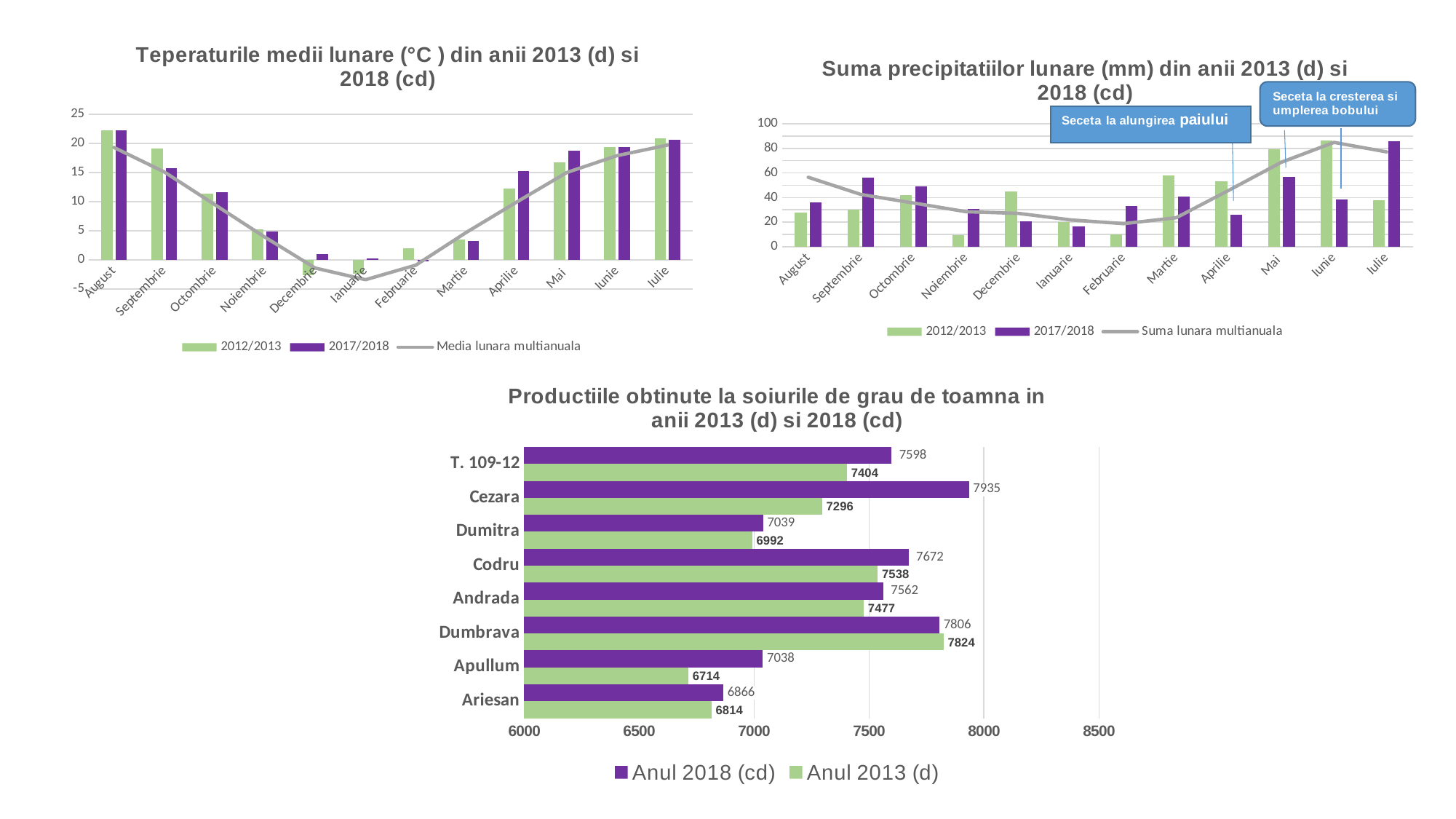
In the top-right chart 'Suma precipitatiilor lunare', which month has the highest 2017/2018 value? Iulie In the chart 'Productiile obtinute la soiurile de grau de toamna', which is larger for Dumbrava: Anul 2018 (cd) or Anul 2013 (d)? Anul 2013 (d) In the top-left chart 'Teperaturile medii lunare', how many entries does the legend list? 3 In the chart 'Productiile obtinute la soiurile de grau de toamna', how many wheat varieties are shown? 8 In the top-left chart 'Teperaturile medii lunare', is the 2012/2013 value for August greater or less than 20? greater In the chart 'Productiile obtinute la soiurile de grau de toamna', what is the value for Dumbrava in Anul 2013 (d)? 7824 In the top-right chart 'Suma precipitatiilor lunare', is the 2012/2013 value for Martie greater or less than 40? greater In the chart 'Productiile obtinute la soiurile de grau de toamna', which variety has the highest value for Anul 2018 (cd)? Cezara In the chart 'Productiile obtinute la soiurile de grau de toamna', which variety has the lowest value for Anul 2013 (d)? Apullum In the chart 'Productiile obtinute la soiurile de grau de toamna', what is the difference between the Anul 2018 (cd) and Anul 2013 (d) values for Cezara? 639 In the chart 'Productiile obtinute la soiurile de grau de toamna', what kind of chart is it? Bar chart In the chart 'Productiile obtinute la soiurile de grau de toamna', what is the value for Cezara in Anul 2018 (cd)? 7935